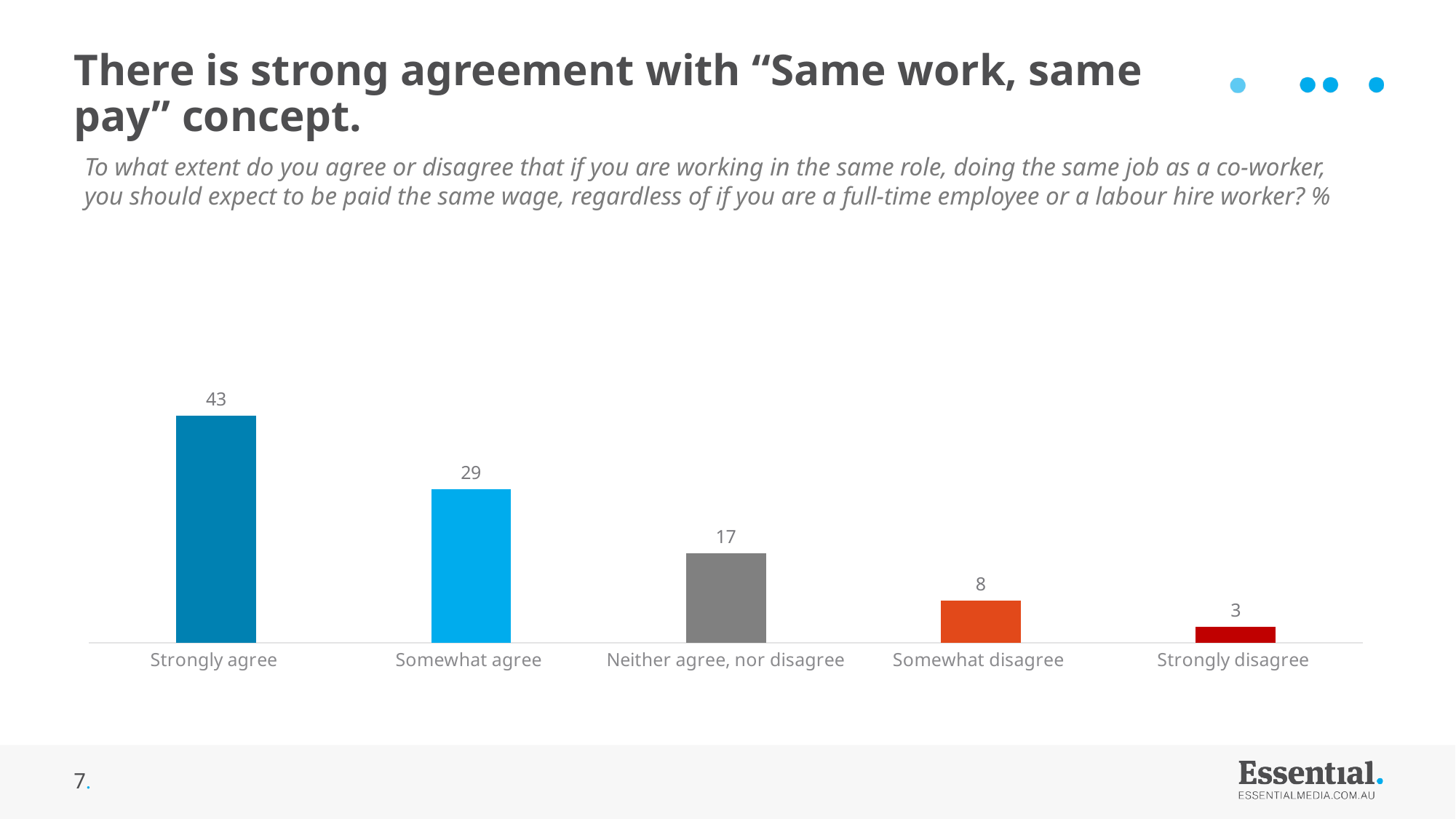
Do the values rise or fall moving from left to right along the x axis? Fall What kind of chart is shown on the slide? Bar chart What is the value for Strongly agree? 43 What is the value for Somewhat disagree? 8 Which category has the lowest value? Strongly disagree What is the value for Neither agree, nor disagree? 17 Which is larger, the value for Neither agree, nor disagree or the value for Somewhat disagree? Neither agree, nor disagree What is the value for Strongly disagree? 3 Which category has the highest value? Strongly agree What is the difference between the values for Strongly agree and Somewhat agree? 14 What is the value for Somewhat agree? 29 How many categories are shown on the x axis? 5